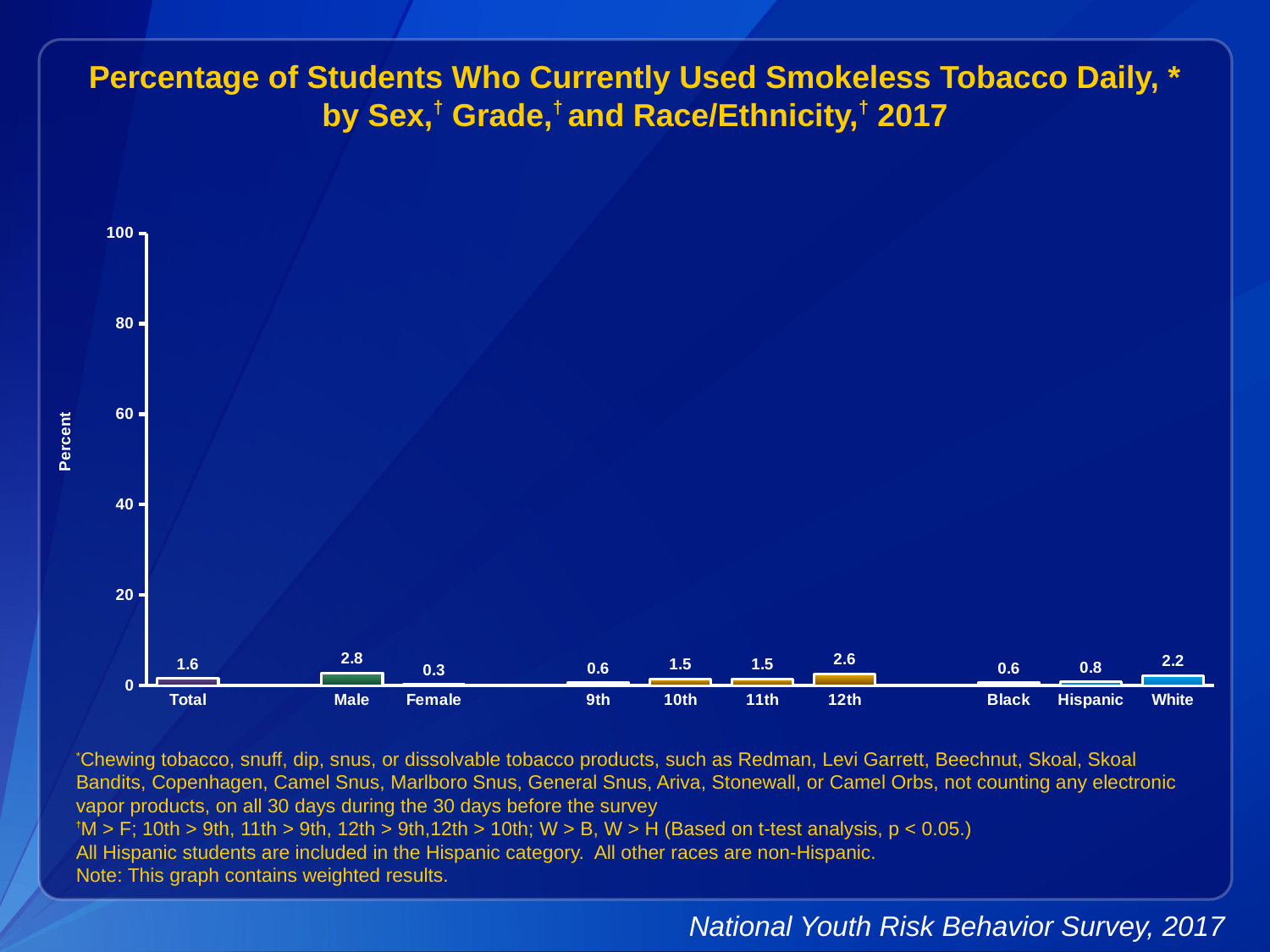
What is the label on the y axis? Percent How many categories are shown on the x axis? 10 What is the difference between the values for White and Black? 1.6 Which is larger, the value for 12th grade or the value for 9th grade? 12th What is the value for 12th grade? 2.6 What is the value for Female? 0.3 What is the difference between the values for Male and Female? 2.5 What is the value for Hispanic students? 0.8 What kind of chart is this? Bar chart Which category has the lowest value? Female What is the value for Male? 2.8 Which category has the highest value? Male